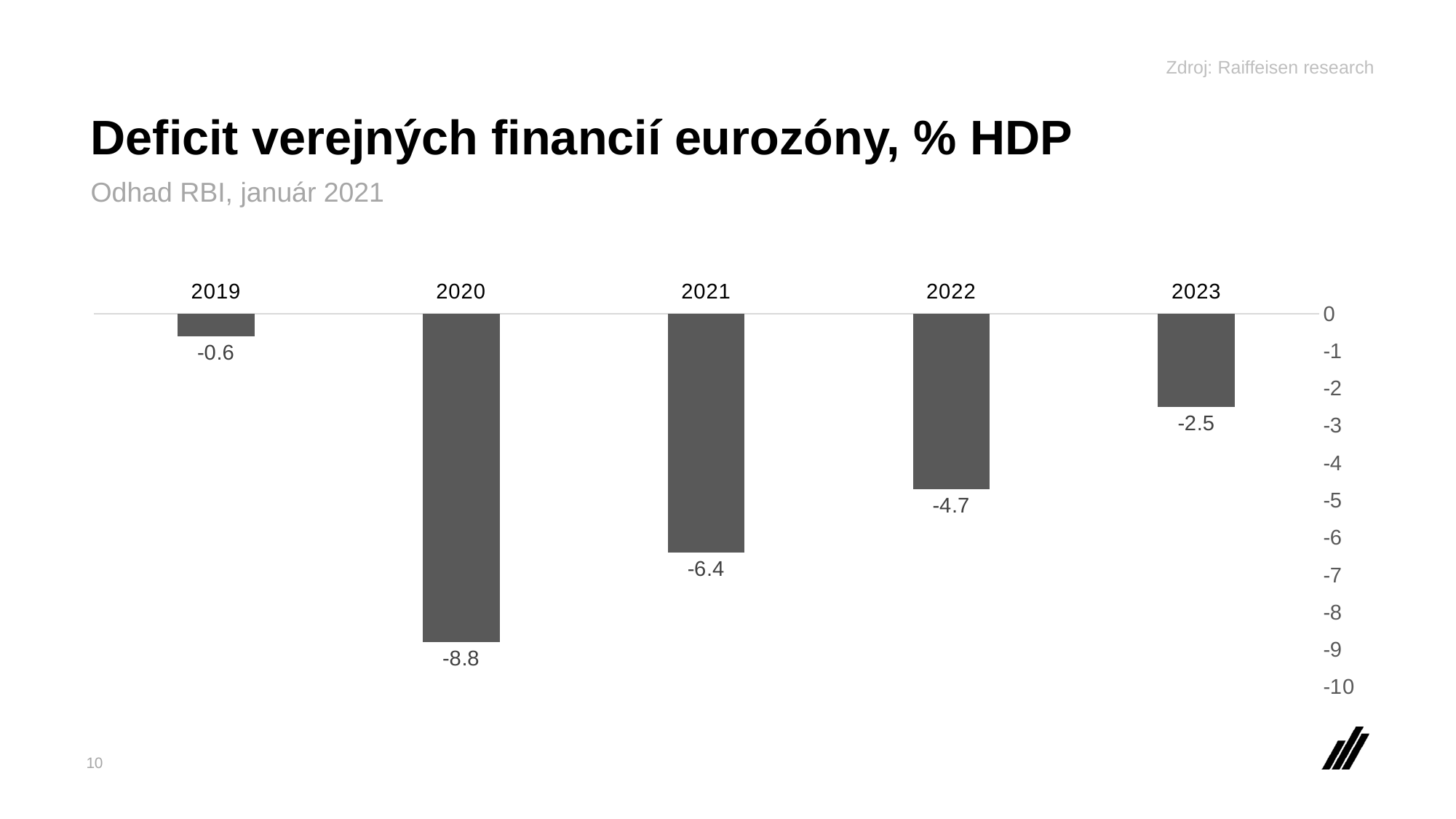
Do the values rise or fall from 2020 to 2023? rise Which is larger, the value for 2021 or the value for 2022? 2022 What is the title of the chart? Deficit verejných financií eurozóny, % HDP How many years are shown on the chart? 5 What is the value for 2019? -0.6 What is the value for 2023? -2.5 What is the difference between the values for 2021 and 2022? 1.7 What is the difference between the values for 2020 and 2023? 6.3 What is the value for 2020? -8.8 Which year has the lowest value (largest deficit)? 2020 Which year has the highest value (smallest deficit)? 2019 What kind of chart is shown on the slide? bar chart